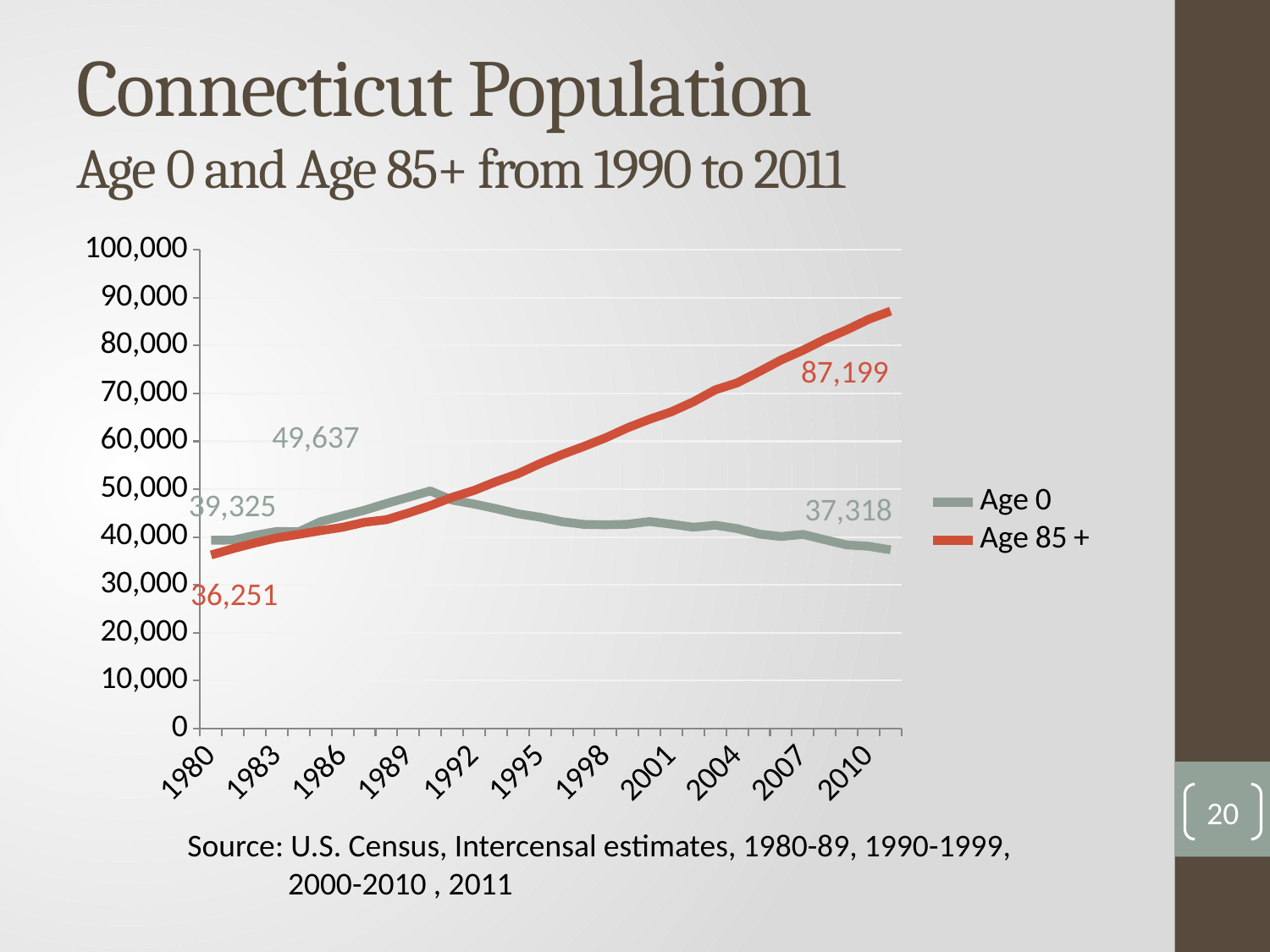
In 1980, which series had the larger value, Age 0 or Age 85+? Age 0 How many series does the legend list? 2 By how much did the Age 85+ population grow from 1980 (36,251) to 2011 (87,199)? 50,948 What is the value for Age 0 in 2011? 37,318 What is the difference between the Age 85+ value (87,199) and the Age 0 value (37,318) in 2011? 49,881 Does the Age 85+ line rise or fall from 1980 to 2011? rise What is the peak value labelled on the Age 0 line? 49,637 What kind of chart is shown on the slide? line chart What is the value for Age 0 in 1980? 39,325 What is the value for Age 85+ in 2011? 87,199 Is the value for Age 85+ in 2001 greater or less than 60,000? greater What is the value for Age 85+ in 1980? 36,251